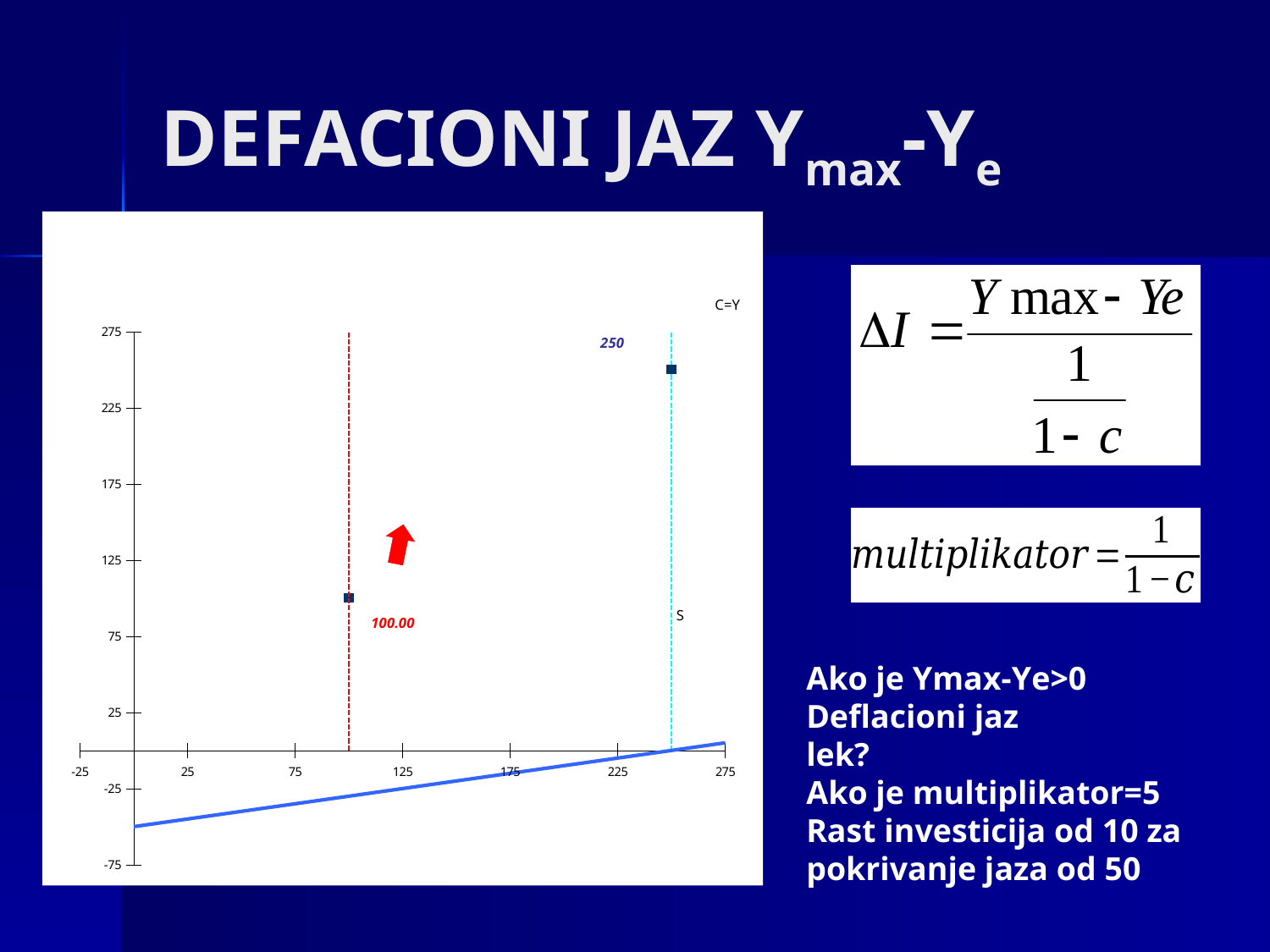
Does the S line rise or fall as x increases? rise Is the value of the S line at x = 275 greater or less than 25? less Is the value of the S line at x = 0 greater or less than -25? less What is the lowest tick value shown on the vertical axis? -75 How many data points on the chart carry a printed value label? 2 What is the title of the slide containing the chart? DEFACIONI JAZ Ymax-Ye What is the highest tick value shown on the vertical axis? 275 Which of the two labelled points has the larger value, the one labelled 100.00 or the one labelled 250? 250 What value is printed as the data label next to the point on the red dashed vertical line? 100.00 What value is printed as the data label next to the point on the cyan dashed vertical line? 250 What label is written at the top right of the plot area, above the point labelled 250? C=Y What is the difference between the two labelled values, 250 and 100.00? 150